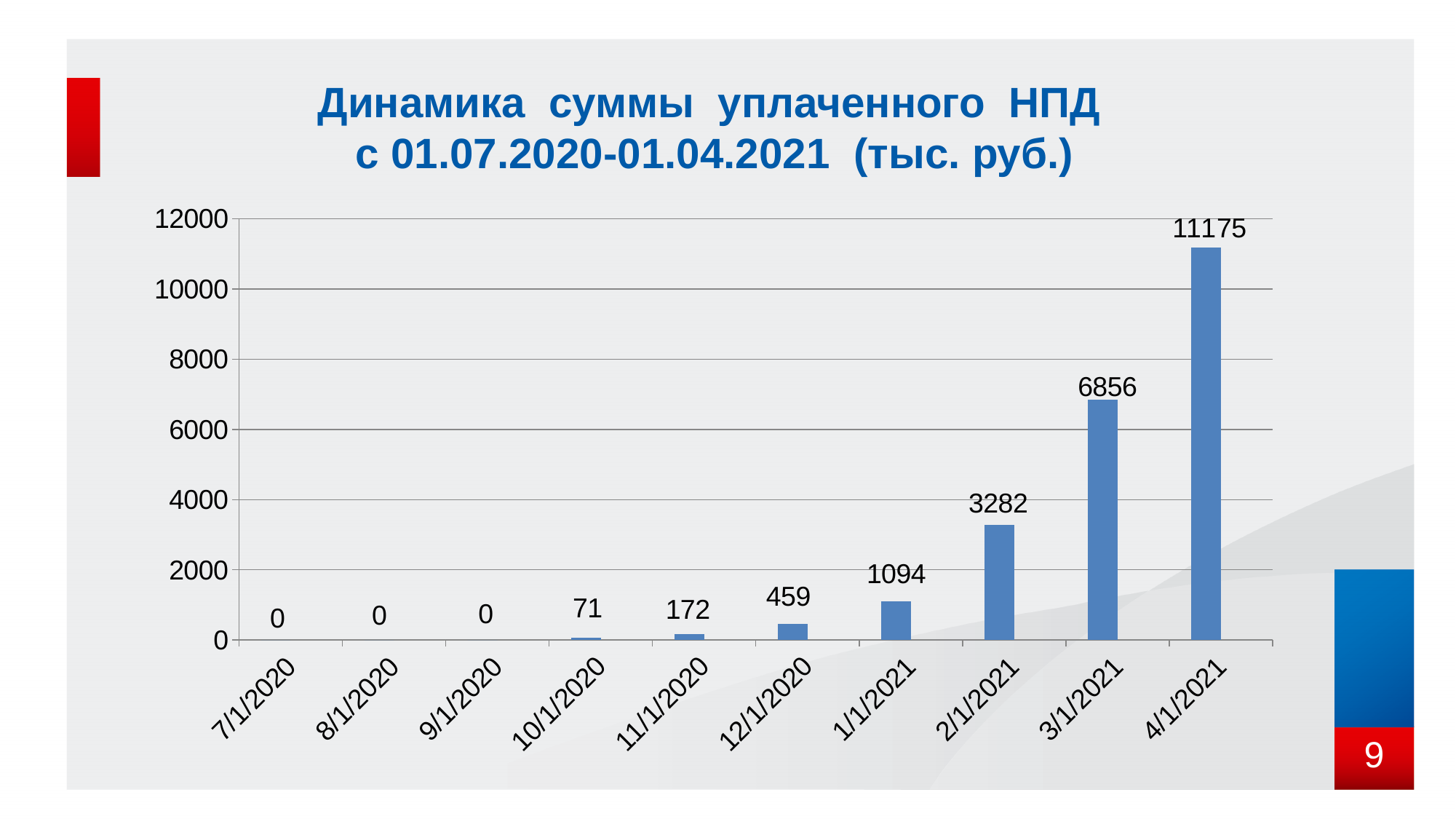
Which is larger, the value for 11/1/2020 or the value for 12/1/2020? 12/1/2020 How many dates are shown on the x axis? 10 How many dates have a value of 0? 3 What is the value for 4/1/2021? 11175 Do the values rise or fall from 7/1/2020 to 4/1/2021? rise Which date has the highest value? 4/1/2021 Is the value for 3/1/2021 greater or less than 6000? greater What is the value for 1/1/2021? 1094 What kind of chart is this? bar chart What is the difference between the values for 4/1/2021 and 3/1/2021? 4319 What is the value for 12/1/2020? 459 What is the difference between the values for 2/1/2021 and 1/1/2021? 2188